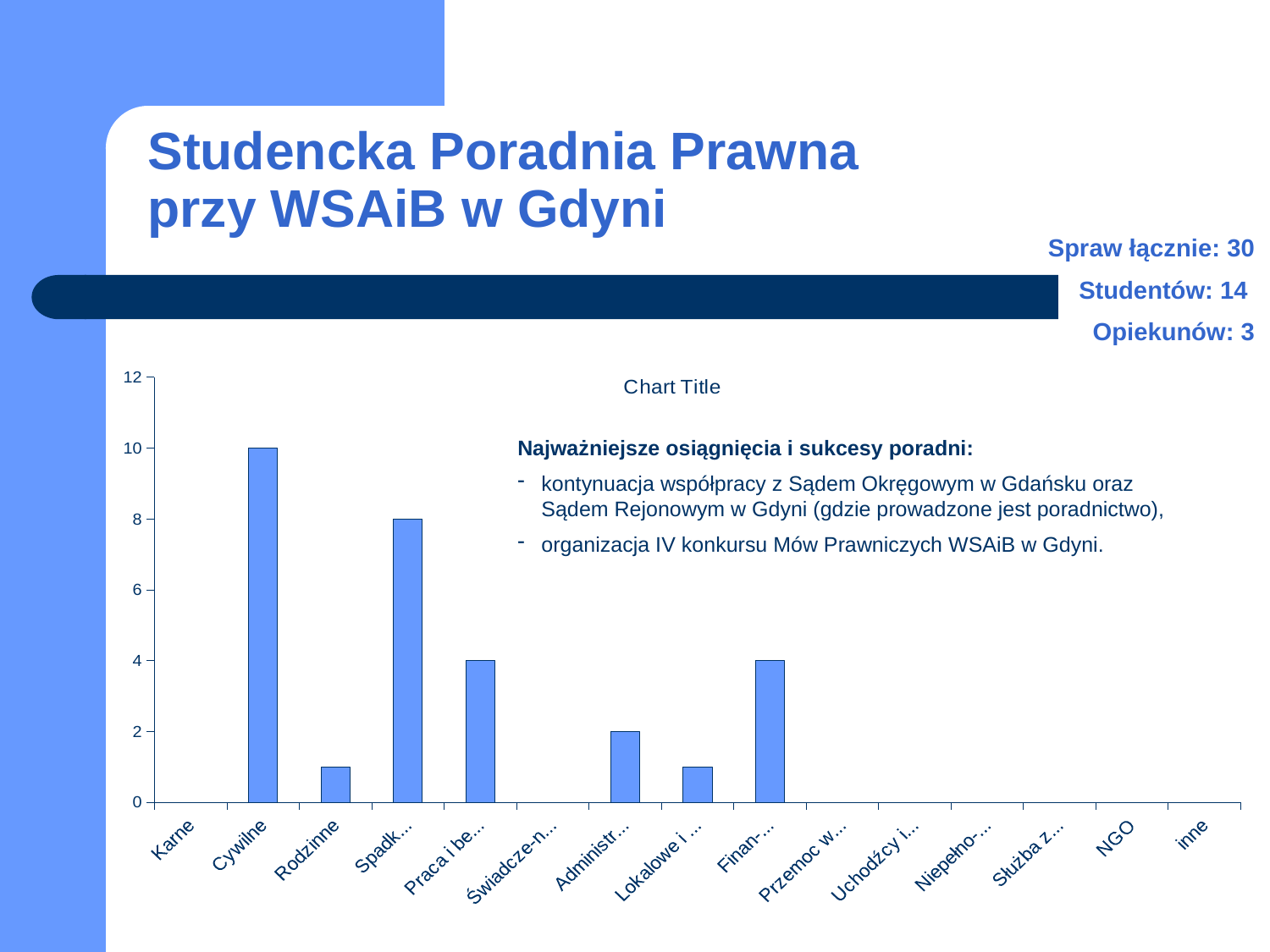
What title is displayed above the chart? Chart Title Is the value for Rodzinne greater or less than 2? less Which is larger, the value for Praca i be... or the value for Administr...? Praca i be... What is the value for Cywilne? 10 What kind of chart is shown on the slide? bar chart What is the value for Administr...? 2 Which category has the highest bar in the chart? Cywilne What is the value for Spadk...? 8 How many categories are shown on the x axis of the chart? 15 Is the value for Lokalowe i ... greater or less than 2? less What is the difference between the values for Cywilne and Spadk...? 2 What is the value for Finan-...? 4